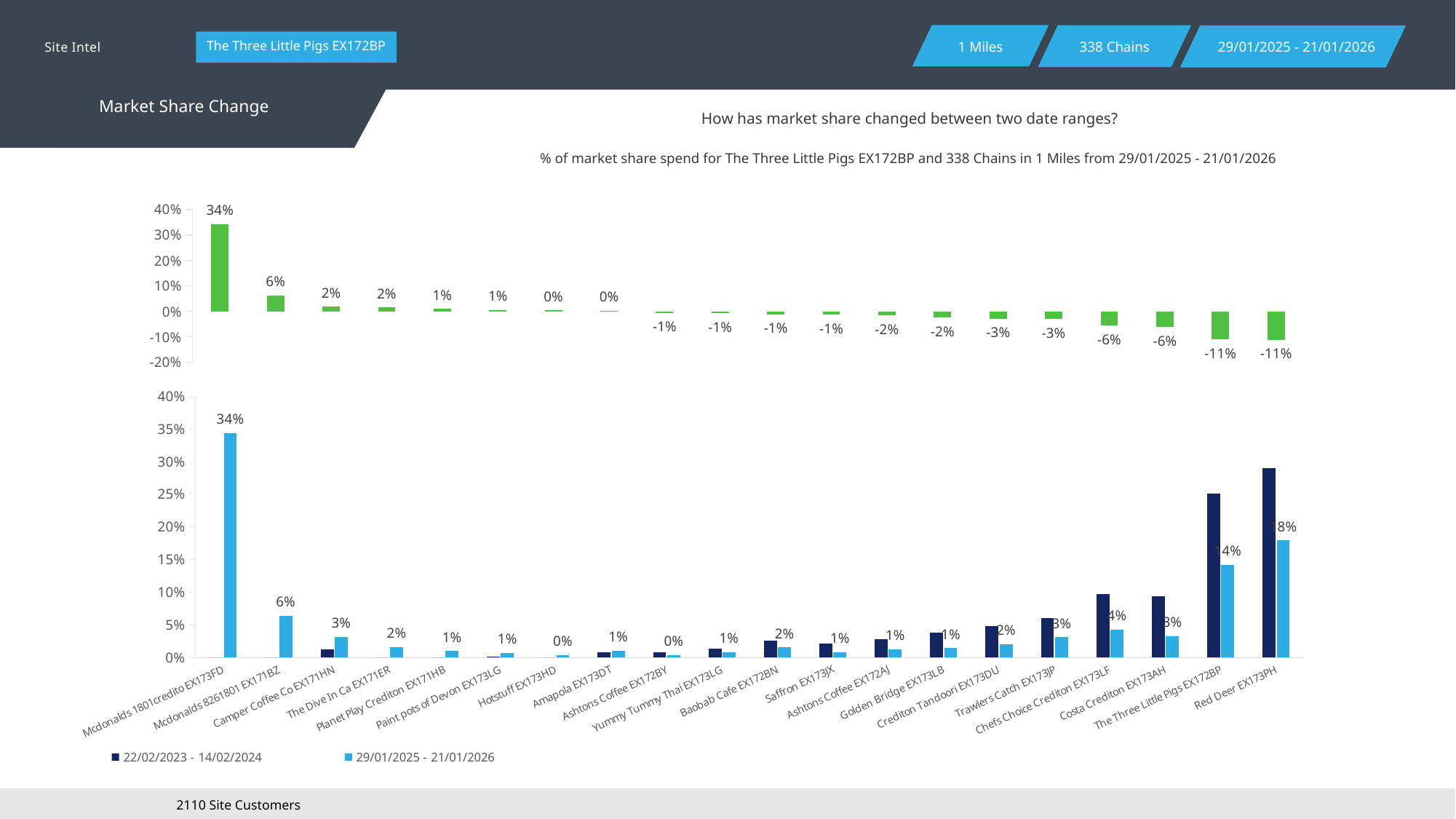
On the bottom chart, what is the value for Chefs Choice Crediton EX173LF in the 29/01/2025 - 21/01/2026 series? 4% On the bottom chart, for The Three Little Pigs EX172BP, which series has the larger value? 22/02/2023 - 14/02/2024 On the bottom chart, is the value for Red Deer EX173PH in the 22/02/2023 - 14/02/2024 series greater or less than 25%? greater How many series does the legend of the bottom chart list? 2 What kind of chart is the bottom chart? bar chart On the bottom chart, which category has the highest value in the 29/01/2025 - 21/01/2026 series? Mcdonalds 1801credito EX173FD How many categories are shown on the bottom chart's x axis? 20 On the top chart, what is the lowest value shown? -11% On the top chart, what is the highest value shown? 34% On the bottom chart, what is the value for Red Deer EX173PH in the 29/01/2025 - 21/01/2026 series? 18% On the bottom chart, what is the value for The Three Little Pigs EX172BP in the 29/01/2025 - 21/01/2026 series? 14% On the bottom chart, what is the difference between the 29/01/2025 - 21/01/2026 values for Red Deer EX173PH and The Three Little Pigs EX172BP? 4 percentage points